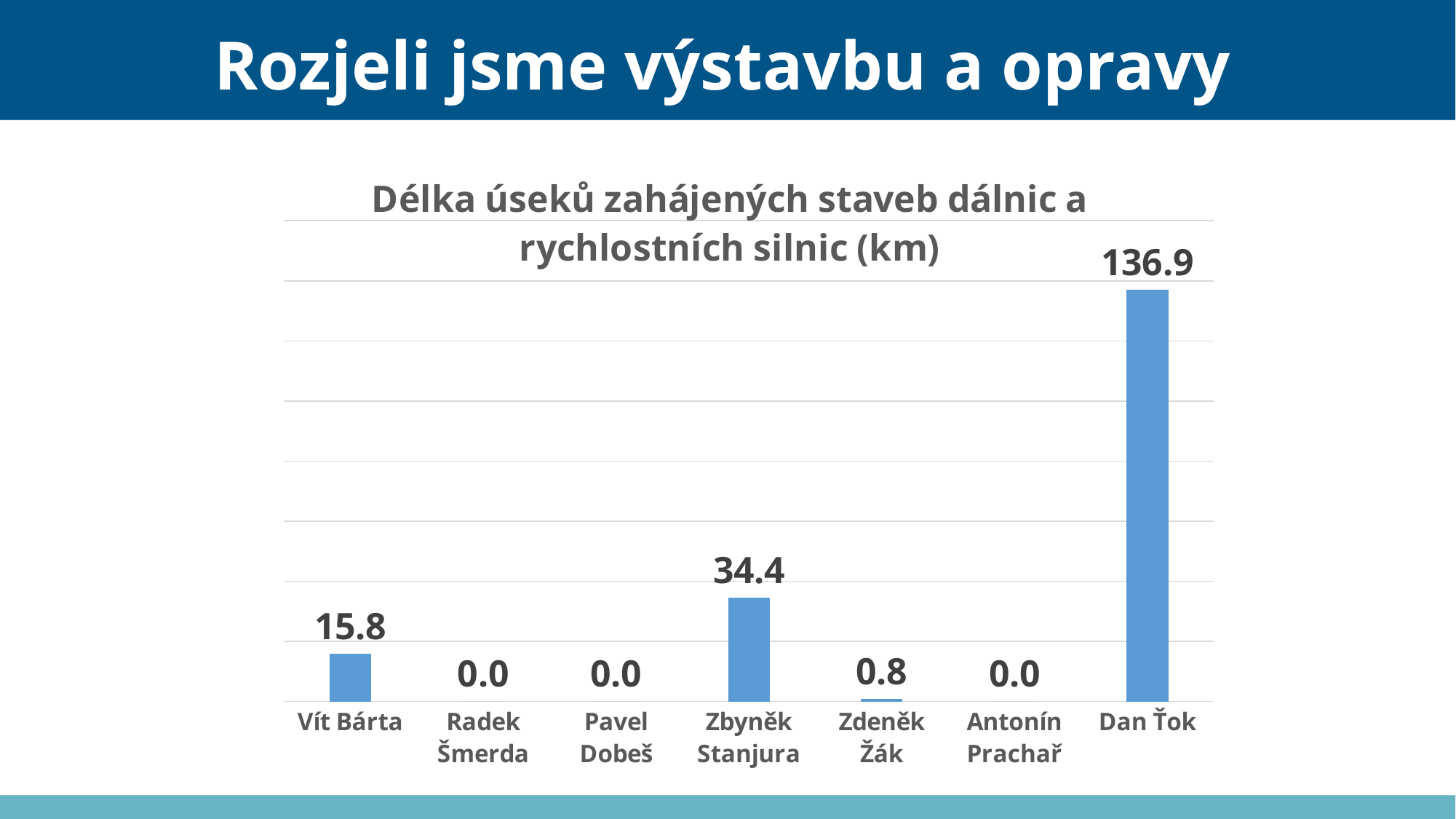
What is the value for Dan Ťok? 136.9 What is the value for Zdeněk Žák? 0.8 How many categories have a value of 0.0? 3 How many categories are shown on the x axis? 7 Which category has the highest value? Dan Ťok What is the difference between the values for Zbyněk Stanjura and Vít Bárta? 18.6 What is the value for Zbyněk Stanjura? 34.4 What is the difference between the values for Dan Ťok and Zbyněk Stanjura? 102.5 What is the title of the chart? Délka úseků zahájených staveb dálnic a rychlostních silnic (km) Which is larger, the value for Vít Bárta or the value for Zdeněk Žák? Vít Bárta What kind of chart is shown on the slide? bar chart What is the value for Vít Bárta? 15.8